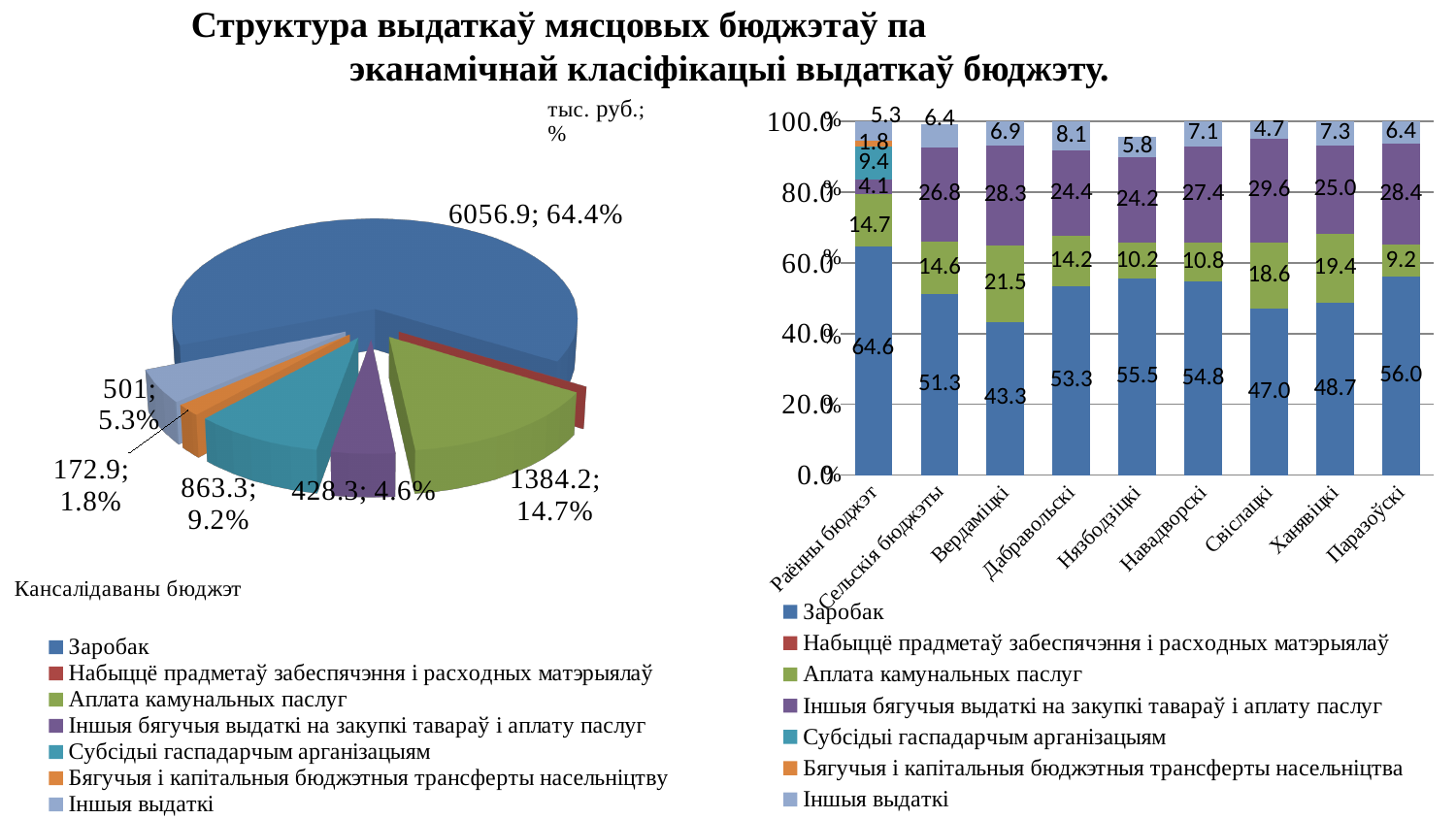
On the left pie chart, what share does the Аплата камунальных паслуг slice have? 14.7% How many categories are shown on the x axis of the right stacked bar chart? 9 On the right stacked bar chart, what is the Заробак value for Вердаміцкі? 43.3 On the left pie chart, what is the value shown for the Субсідыі гаспадарчым арганізацыям slice? 863.3 On the right stacked bar chart, what is the difference between the Заробак values for Паразоўскі and Свіслацкі? 9.0 What kind of chart is the left chart on the slide? Pie chart On the left pie chart, which slice is the smallest among the labelled slices? Бягучыя і капітальныя бюджэтныя трансферты насельніцтву (172.9; 1.8%) On the right stacked bar chart, which is larger: the Аплата камунальных паслуг value for Вердаміцкі or for Ханявіцкі? Вердаміцкі (21.5) How many series does the legend of the right stacked bar chart list? 7 On the right stacked bar chart, which category has the highest Заробак value? Раённы бюджэт (64.6) On the left chart (Кансалідаваны бюджэт), what value and share are shown for the largest slice, Заробак? 6056.9; 64.4% On the right stacked bar chart, which category has the lowest Заробак value? Вердаміцкі (43.3)